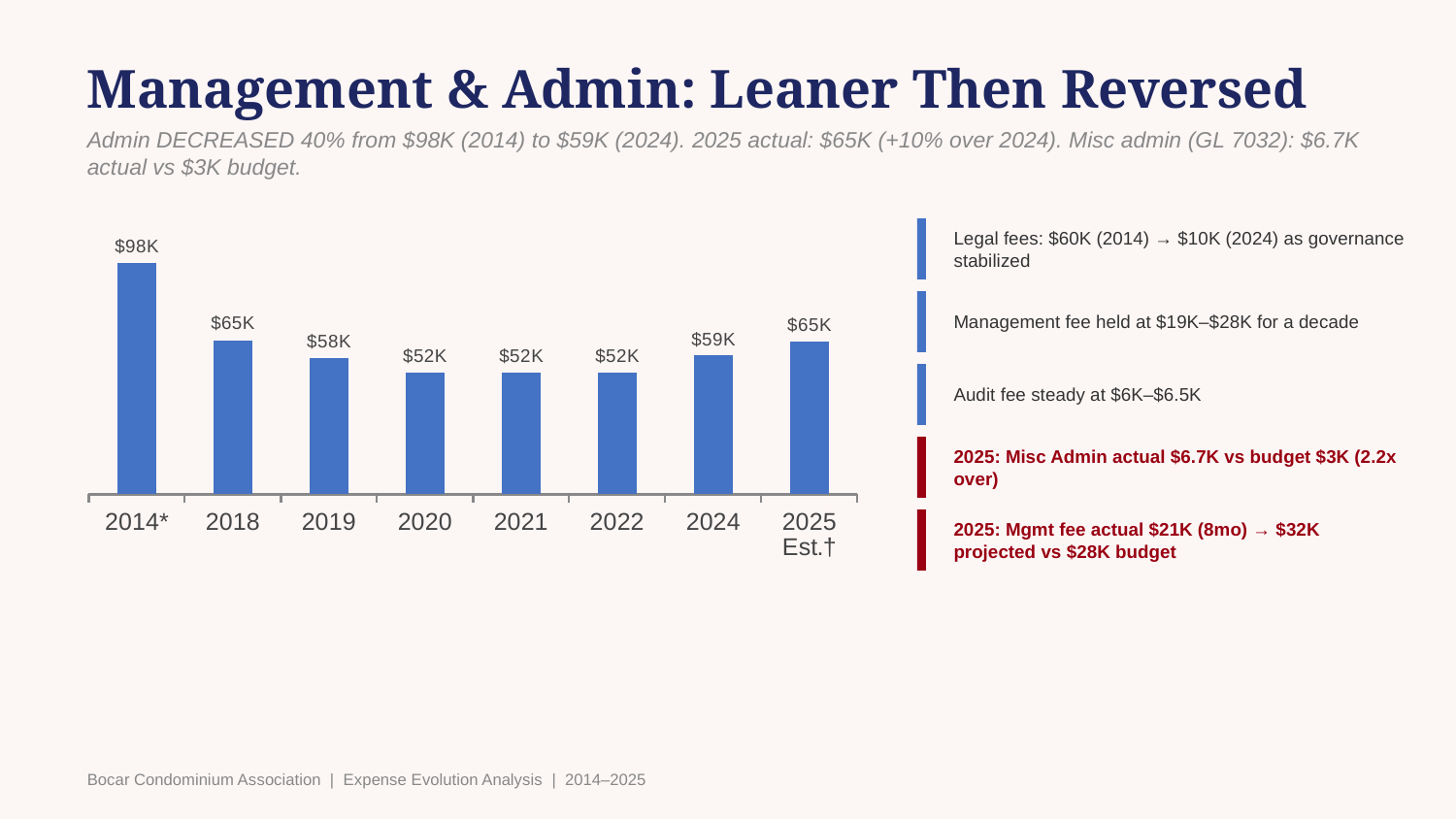
What is the value for 2024? $59K Do the values rise or fall from 2014* to 2020? Fall What kind of chart is shown on the slide? Bar chart Which year has the highest value? 2014* What is the value for 2025 Est.†? $65K How many bars are shown in the chart? 8 What is the difference between the 2014* value and the 2024 value? $39K What is the value for 2019? $58K Which is larger, the value for 2018 or the value for 2019? 2018 What is the difference between the 2025 Est.† value and the 2024 value? $6K What colour are the bars in the chart? Blue What is the value for 2014*? $98K